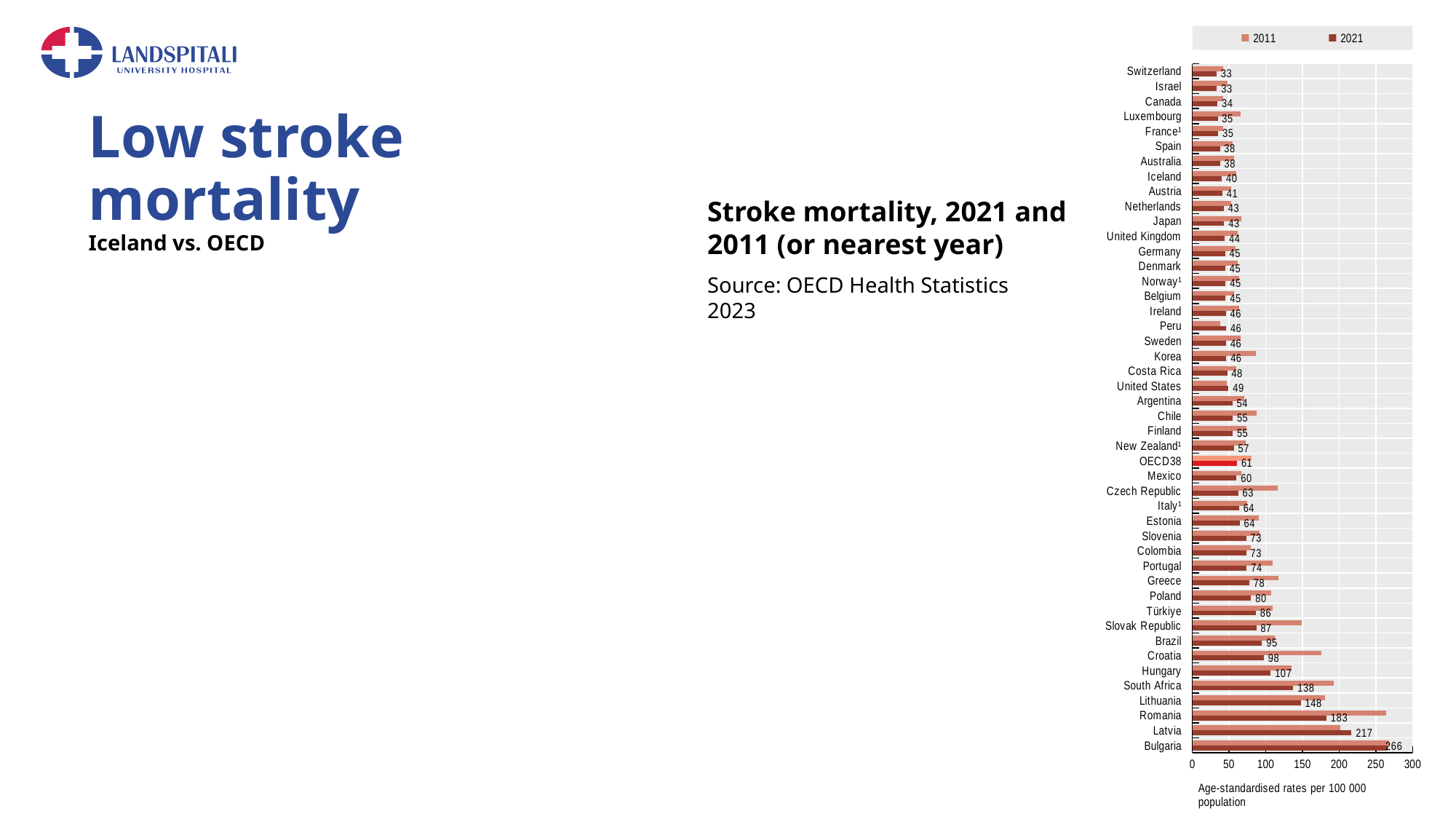
Is the 2011 stroke mortality rate for Croatia greater or less than 150? greater Which has a higher 2021 stroke mortality rate, Latvia or Romania? Latvia Which country has the highest 2021 stroke mortality rate? Bulgaria Which country has the lowest 2021 stroke mortality rate? Switzerland and Israel (both 33) How many series does the legend list? 2 What is the title of the chart? Stroke mortality, 2021 and 2011 (or nearest year) What is the 2021 stroke mortality rate for OECD38? 61 Is the 2011 stroke mortality rate for Romania greater or less than 250? greater What is the 2021 stroke mortality rate for Iceland? 40 What is the 2021 stroke mortality rate for Bulgaria? 266 What kind of chart is shown on the slide? Bar chart What is the difference between the 2021 stroke mortality rates of OECD38 and Iceland? 21